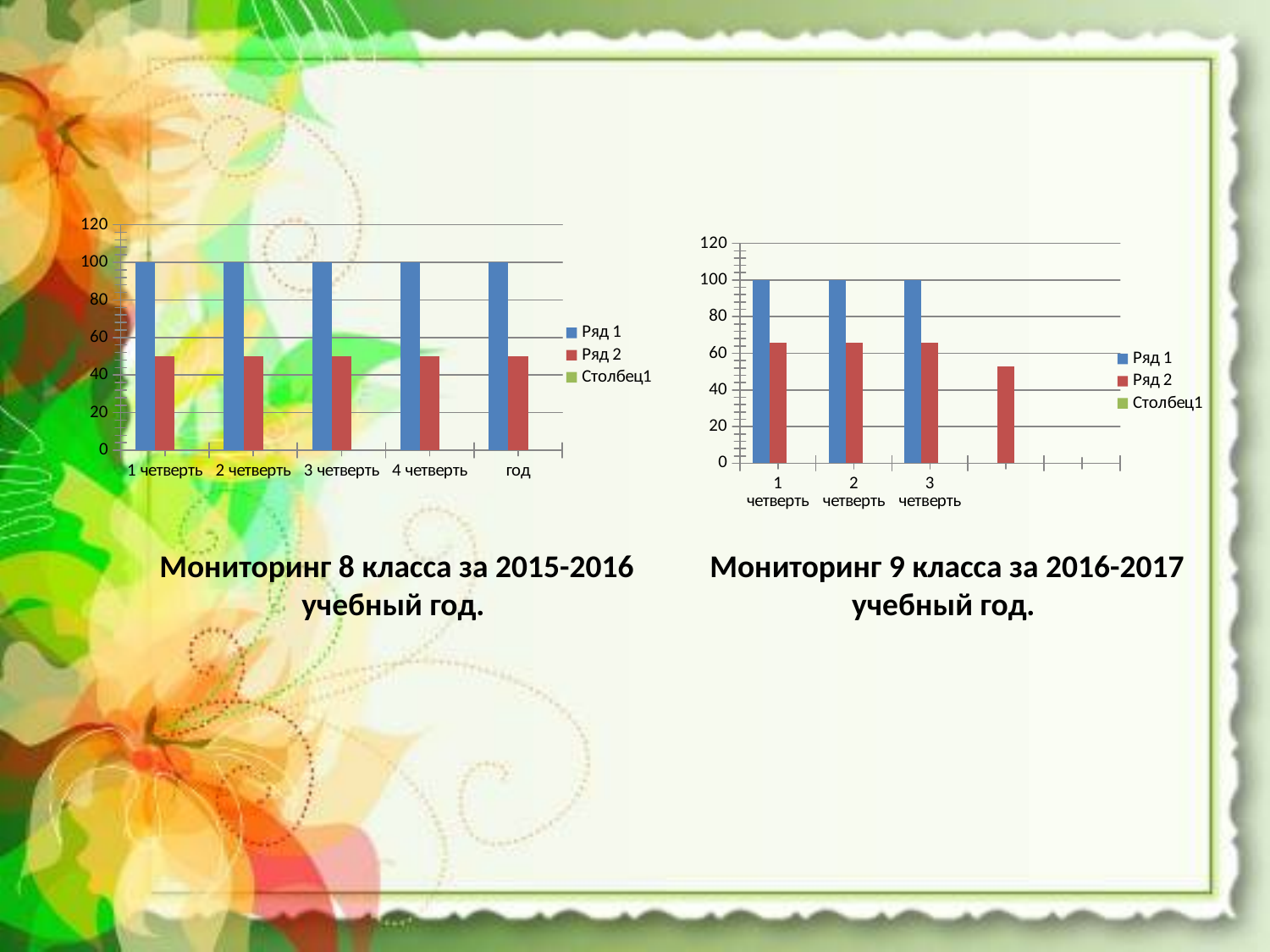
In the chart titled "Мониторинг 8 класса за 2015-2016 учебный год", is the value of Ряд 2 for 3 четверть greater or less than 60? less In the chart titled "Мониторинг 9 класса за 2016-2017 учебный год", is the value of Ряд 2 for 1 четверть greater or less than 60? greater What are the legend entries of the chart titled "Мониторинг 9 класса за 2016-2017 учебный год"? Ряд 1, Ряд 2, Столбец1 In the chart titled "Мониторинг 8 класса за 2015-2016 учебный год", do the values of Ряд 1 rise, fall or stay the same across the categories? stay the same How many series does the legend of the chart titled "Мониторинг 8 класса за 2015-2016 учебный год" list? 3 In the chart titled "Мониторинг 9 класса за 2016-2017 учебный год", what is the value of Ряд 1 for 2 четверть? 100 In the chart titled "Мониторинг 8 класса за 2015-2016 учебный год", what is the value of Ряд 1 for 1 четверть? 100 In the chart titled "Мониторинг 9 класса за 2016-2017 учебный год", which is larger for 3 четверть: Ряд 1 or Ряд 2? Ряд 1 In the chart titled "Мониторинг 8 класса за 2015-2016 учебный год", is the value of Ряд 2 for год greater or less than 40? greater In the chart titled "Мониторинг 8 класса за 2015-2016 учебный год", which is larger for 2 четверть: Ряд 1 or Ряд 2? Ряд 1 In the chart titled "Мониторинг 8 класса за 2015-2016 учебный год", how many categories are shown on the x axis? 5 What kind of chart is the chart titled "Мониторинг 8 класса за 2015-2016 учебный год"? bar chart